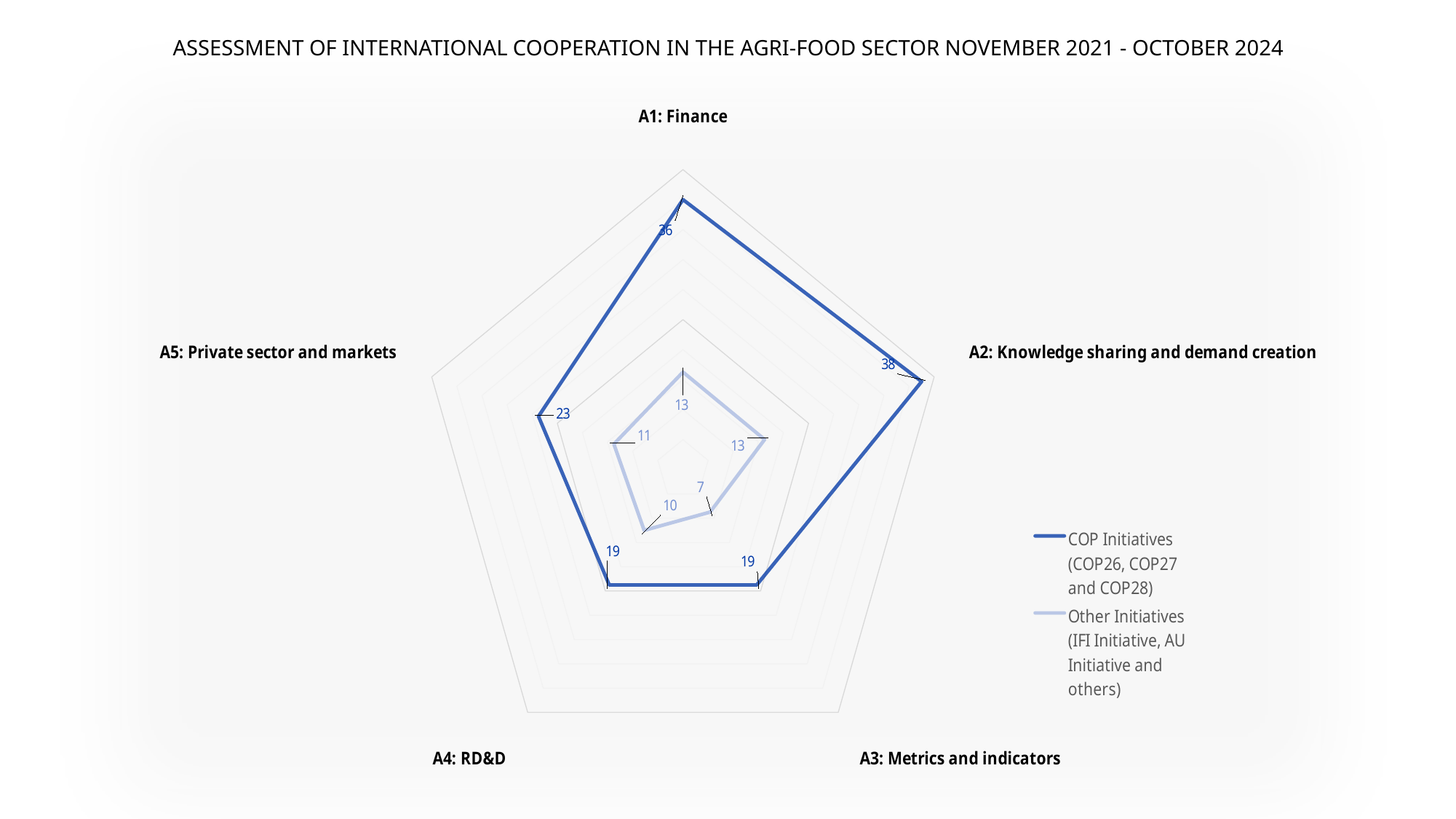
What is the difference between the COP Initiatives values on A1: Finance and A5: Private sector and markets? 13 Which category has the lowest value for Other Initiatives? A3: Metrics and indicators What is the value for COP Initiatives on A5: Private sector and markets? 23 What is the difference between the COP Initiatives and Other Initiatives values on A2: Knowledge sharing and demand creation? 25 How many categories (axes) does the radar chart have? 5 What is the value for Other Initiatives on A3: Metrics and indicators? 7 What is the value for COP Initiatives on A1: Finance? 36 How many series does the legend list? 2 Which is larger for Other Initiatives: the value on A4: RD&D or the value on A3: Metrics and indicators? A4: RD&D What type of chart is shown on the slide? Radar chart What is the title of the chart? ASSESSMENT OF INTERNATIONAL COOPERATION IN THE AGRI-FOOD SECTOR NOVEMBER 2021 - OCTOBER 2024 Which category has the highest value for COP Initiatives? A2: Knowledge sharing and demand creation